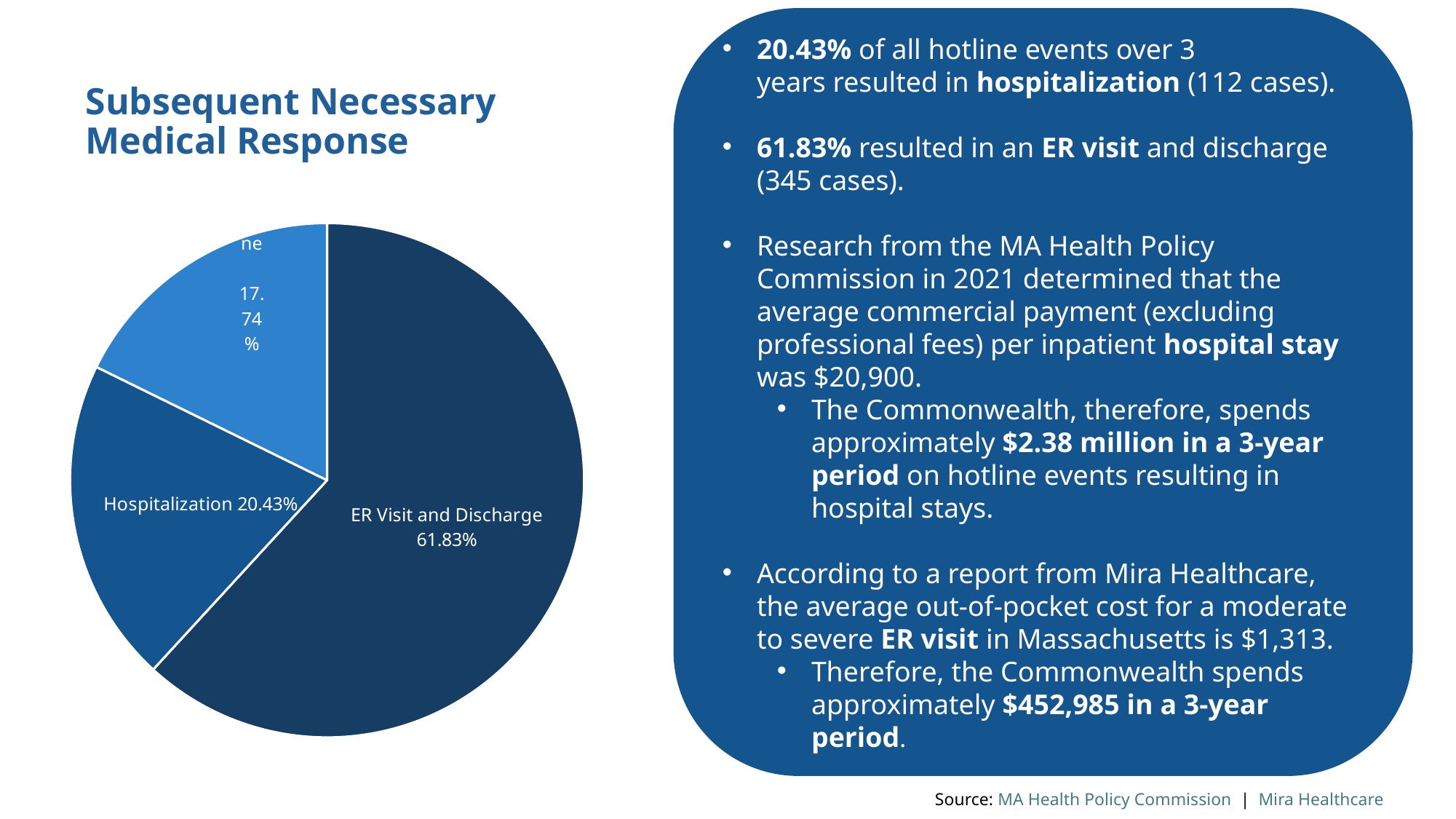
What is the title of the slide containing the pie chart? Subsequent Necessary Medical Response Which is larger, the ER Visit and Discharge slice or the Hospitalization slice? ER Visit and Discharge What kind of chart is shown on the slide? pie chart What is the difference in percentage points between the ER Visit and Discharge slice and the Hospitalization slice? 41.40 Is the share for Hospitalization greater or less than 25%? less Which slice of the pie chart is shown in the lightest blue colour? the 17.74% slice Is the share for ER Visit and Discharge greater or less than 50%? greater What share of the pie does ER Visit and Discharge represent? 61.83% How many slices does the pie chart have? 3 Which slice of the pie chart is the largest? ER Visit and Discharge What share of the pie does Hospitalization represent? 20.43%